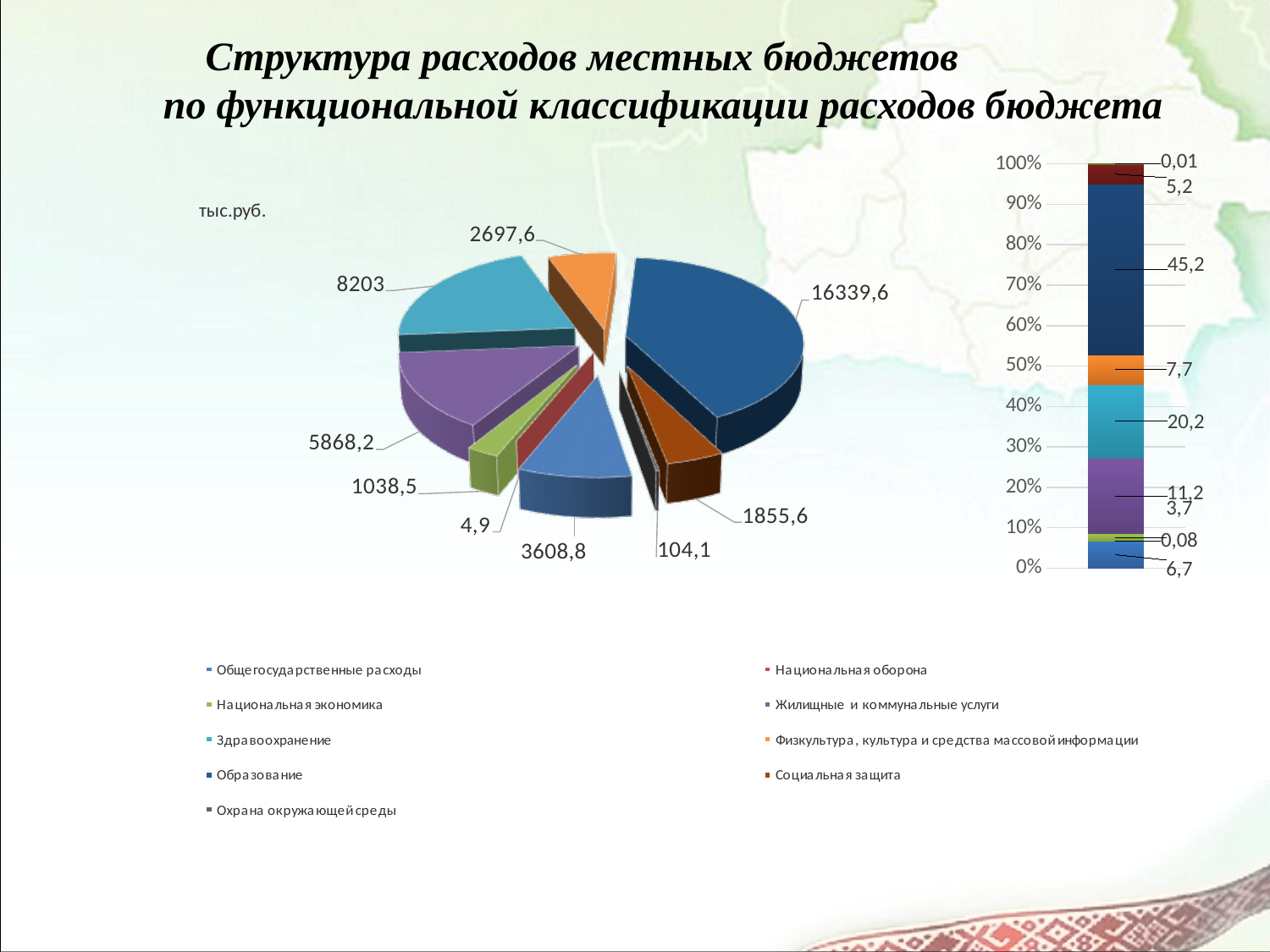
In the pie chart, which category has the smallest value? Национальная оборона In the pie chart, which category has the largest value? Образование In the pie chart, which is larger: Общегосударственные расходы or Физкультура, культура и средства массовой информации? Общегосударственные расходы In the pie chart, what is the difference between the values for Здравоохранение and Жилищные и коммунальные услуги? 2334,8 In the stacked bar chart, what is the value labelled for the Образование segment? 45,2 In the pie chart, what is the value for Образование? 16339,6 What kind of chart is the chart on the right of the slide? stacked bar chart How many categories does the legend list? 9 In the pie chart, what is the value for Жилищные и коммунальные услуги? 5868,2 What kind of chart is the chart on the left of the slide? pie chart In the pie chart, what is the value for Здравоохранение? 8203 What unit is shown above the pie chart? тыс.руб.